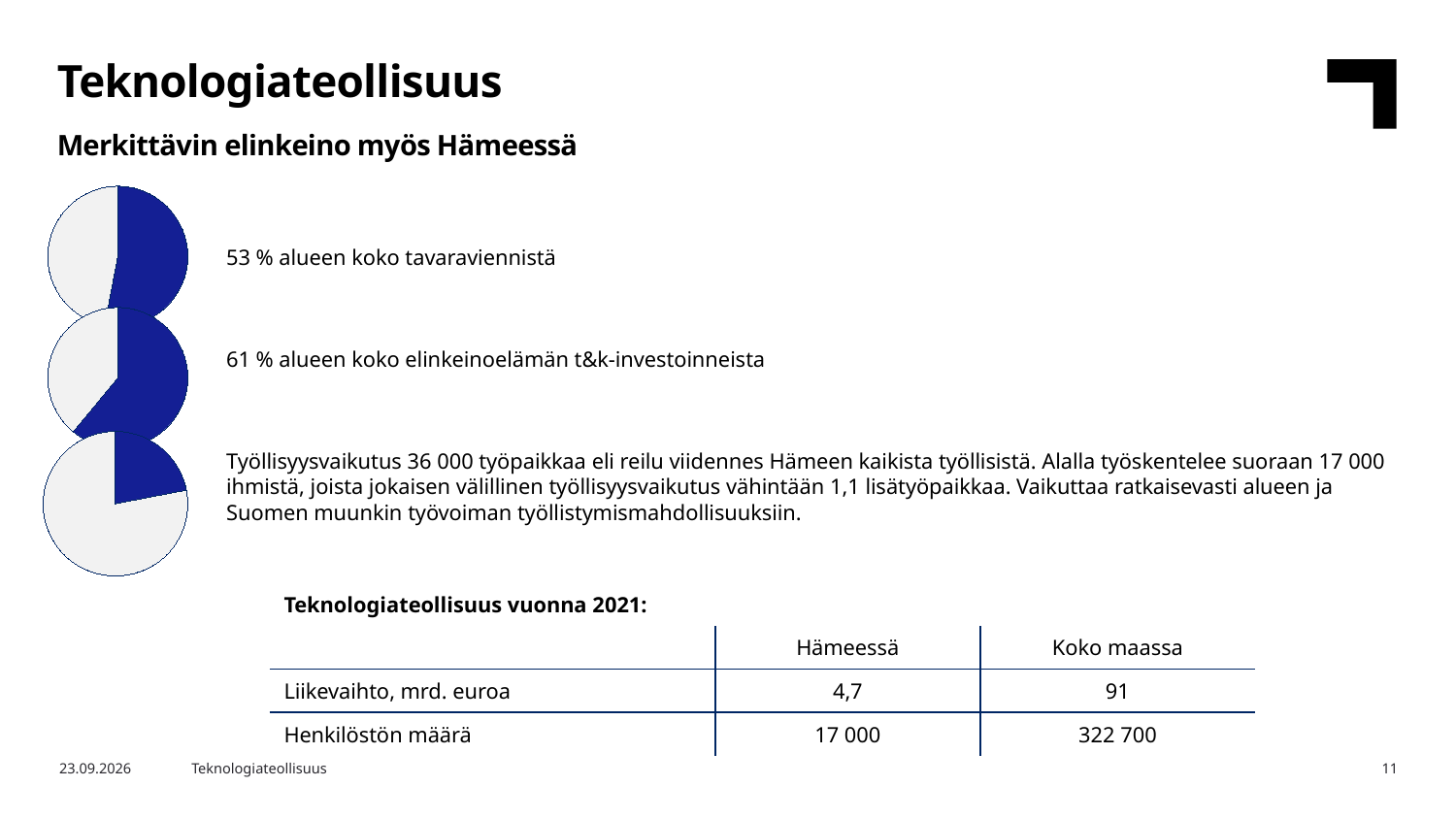
Which pie chart has the larger blue slice, the top one or the middle one? The middle one Is the blue slice of the bottom pie chart greater or less than half of the pie? less What kind of charts are shown on the left side of the slide? Pie charts What is the difference in percentage points between the shares shown for the middle pie chart (61 %) and the top pie chart (53 %)? 8 percentage points How many slices does each pie chart on the slide have? 2 How many pie charts are on the slide? 3 For the middle pie chart, what share of the region's business R&D investments does the blue slice represent, according to the text next to it? 61 % Which of the three pie charts has the largest blue slice? The middle one Is the blue slice of the middle pie chart greater or less than half of the pie? greater What colour is used for the highlighted slice in the pie charts? Dark blue For the top pie chart, what share of the region's total goods exports does the blue slice represent, according to the text next to it? 53 % Which of the three pie charts has the smallest blue slice? The bottom one